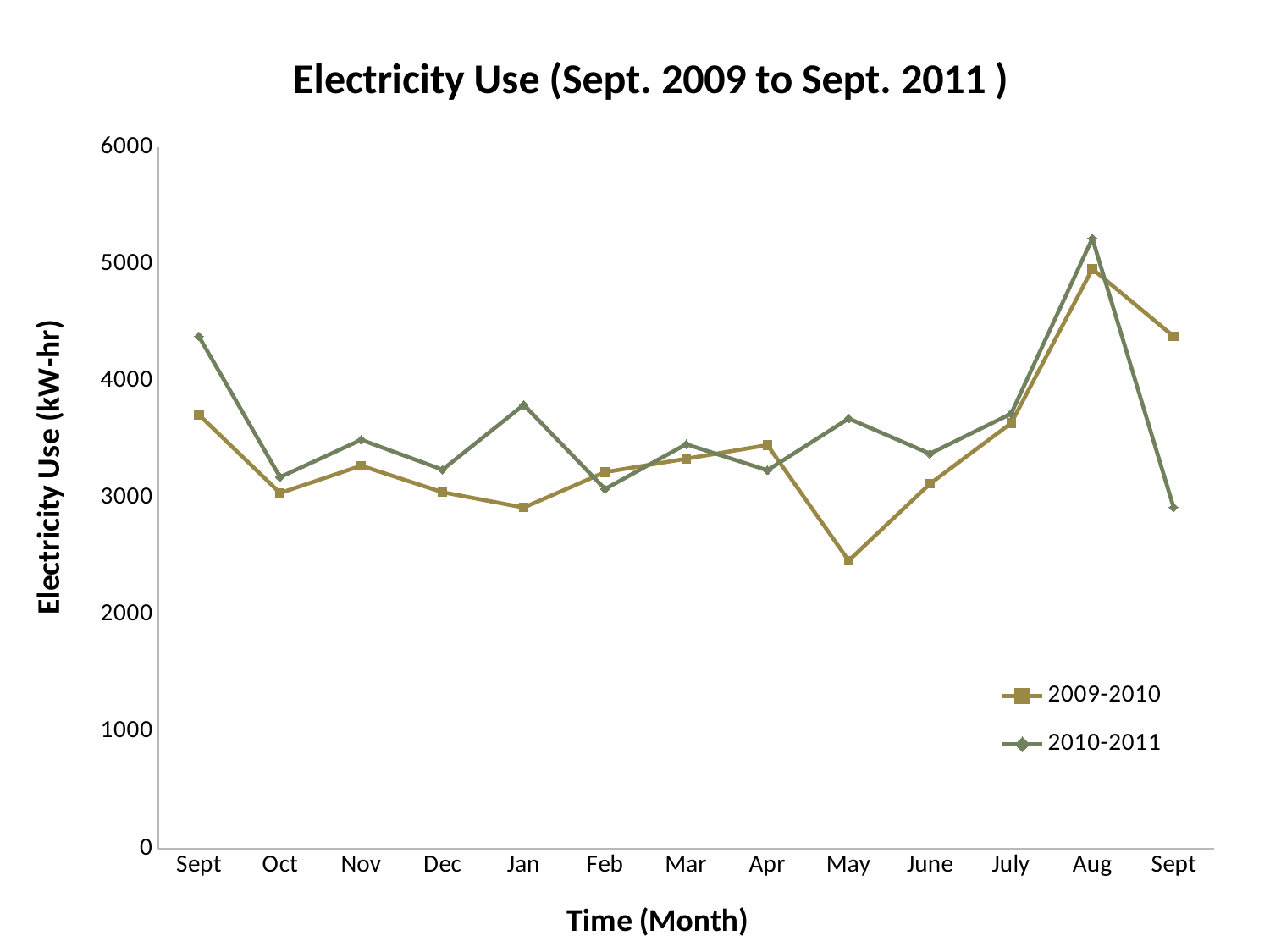
Which series has the larger value at the final Sept point, 2009-2010 or 2010-2011? 2009-2010 In which month does the 2009-2010 series reach its lowest value? May Is the 2009-2010 value for May greater or less than 3000? less What is the title of the y axis? Electricity Use (kW-hr) In which month does the 2010-2011 series reach its highest value? Aug How many series does the legend list? 2 Is the 2010-2011 value for Aug greater or less than 5000? greater Is the 2010-2011 value for Jan greater or less than 3500? greater In which month does the 2009-2010 series reach its highest value? Aug What kind of chart is shown on the slide? line chart Which series has the larger value in May, 2009-2010 or 2010-2011? 2010-2011 How many months are plotted along the x axis? 13